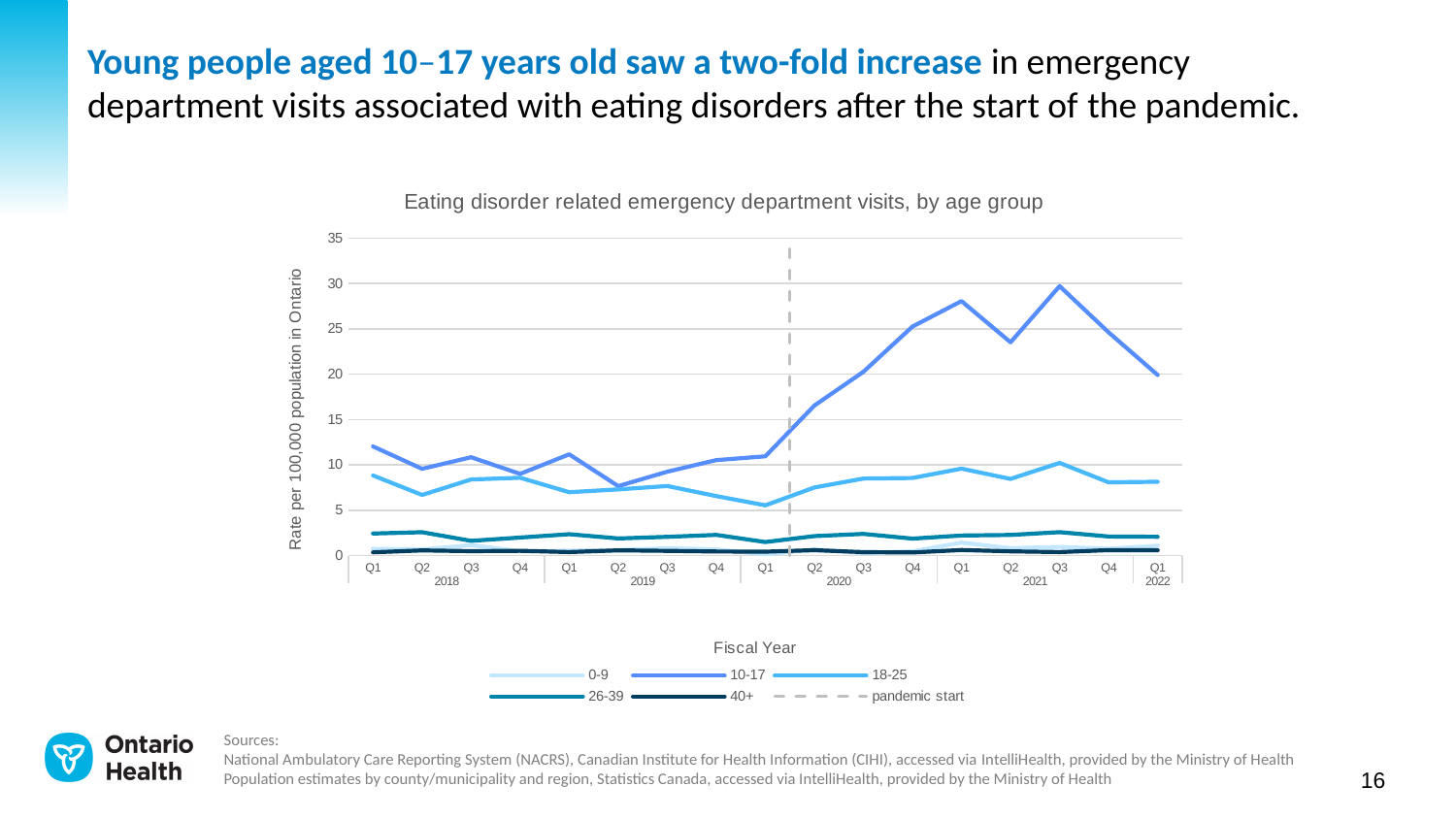
In Q1 2022, which age group has the higher rate: 10-17 or 18-25? 10-17 How many entries does the chart legend list? 6 What type of chart is shown on the slide? Line chart Does the rate for the 10-17 age group rise or fall between Q1 2020 and Q1 2021? rise How many quarterly data points are shown along the x axis, from Q1 2018 to Q1 2022? 17 Which age group has the highest rate in Q3 2021? 10-17 What is the title of the chart? Eating disorder related emergency department visits, by age group How many age groups are plotted as lines in the chart? 5 Is the rate for the 18-25 age group in Q1 2020 greater or less than 10? less What does the dashed vertical grey line in the chart represent, according to the legend? pandemic start Is the rate for the 10-17 age group in Q3 2021 greater or less than 25? greater In which quarter does the 10-17 age group reach its highest rate? Q3 2021